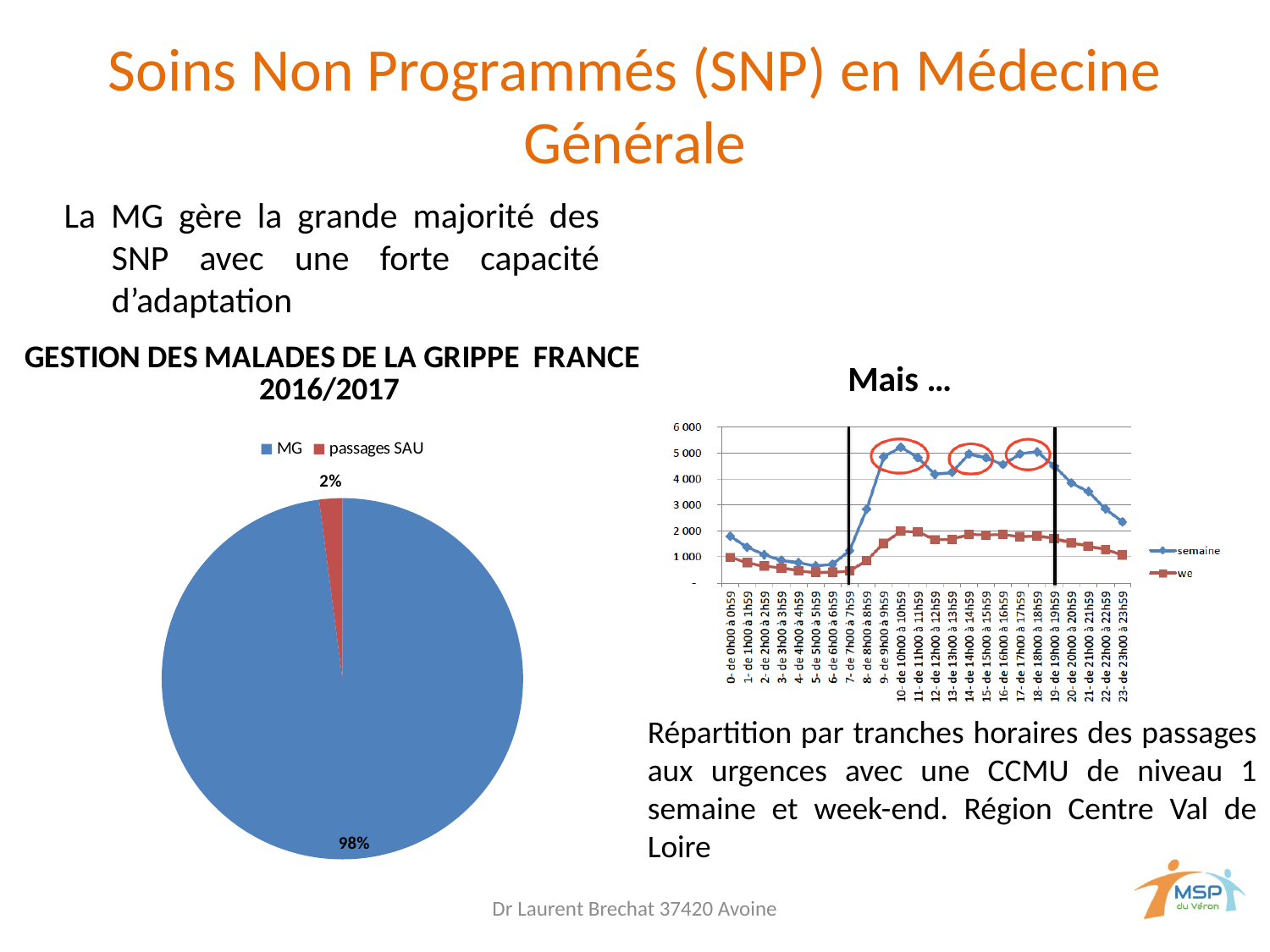
What kind of chart is the chart titled 'Mais ...' on the right of the slide? Line chart How many entries does the legend of the pie chart 'GESTION DES MALADES DE LA GRIPPE FRANCE 2016/2017' list? 2 In the chart titled 'Mais ...', is the 'semaine' value for '10- de 10h00 à 10h59' greater or less than 4 000? greater In the pie chart 'GESTION DES MALADES DE LA GRIPPE FRANCE 2016/2017', what share is shown for passages SAU? 2% In the chart titled 'Mais ...', how many time slots are shown on the x axis? 24 In the pie chart 'GESTION DES MALADES DE LA GRIPPE FRANCE 2016/2017', what is the difference in percentage points between MG and passages SAU? 96% What kind of chart is the chart on the left of the slide? Pie chart In the chart titled 'Mais ...', is the 'we' value for '10- de 10h00 à 10h59' greater or less than 3 000? less In the chart titled 'Mais ...', how many series does the legend list? 2 In the chart titled 'Mais ...', do the 'semaine' values rise or fall from '19- de 19h00 à 19h59' to '23- de 23h00 à 23h59'? fall In the pie chart 'GESTION DES MALADES DE LA GRIPPE FRANCE 2016/2017', what share is shown for MG? 98% In the pie chart 'GESTION DES MALADES DE LA GRIPPE FRANCE 2016/2017', which category has the largest slice? MG